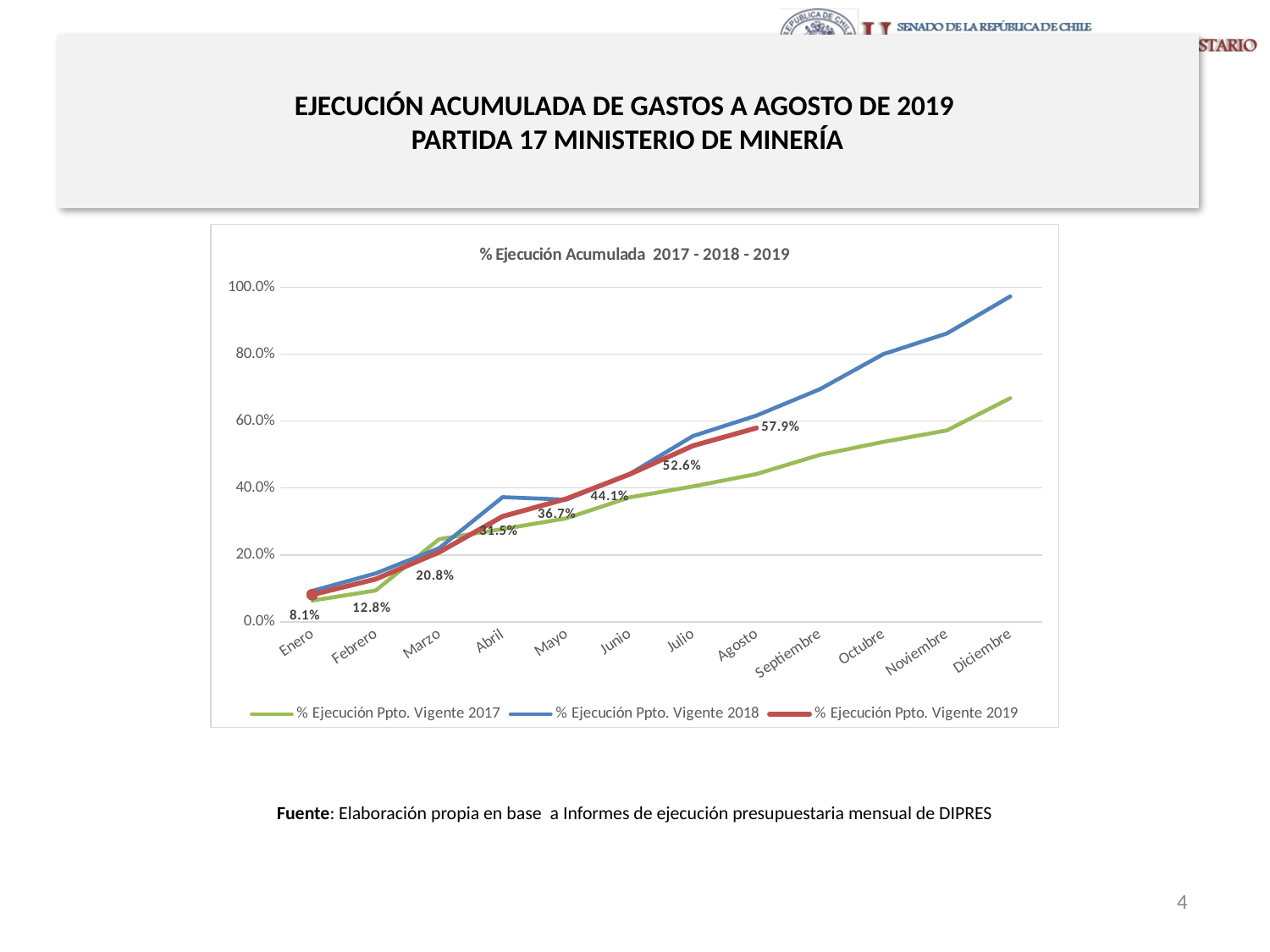
What is the value of % Ejecución Ppto. Vigente 2019 for Junio? 44.1% How many series does the legend list? 3 What is the value of % Ejecución Ppto. Vigente 2019 for Agosto? 57.9% Does the % Ejecución Ppto. Vigente 2019 series rise or fall from Enero to Agosto? rise Which series has the higher value in Diciembre, 2017 or 2018? % Ejecución Ppto. Vigente 2018 What is the difference between the 2019 values for Marzo and Febrero? 8.0% What is the title of the chart? % Ejecución Acumulada 2017 - 2018 - 2019 What is the value of % Ejecución Ppto. Vigente 2019 for Abril? 31.5% What type of chart is shown on the slide? line chart What is the difference between the 2019 values for Agosto and Julio? 5.3% Is the value of % Ejecución Ppto. Vigente 2018 for Diciembre greater or less than 80.0%? greater What is the value of % Ejecución Ppto. Vigente 2019 for Enero? 8.1%